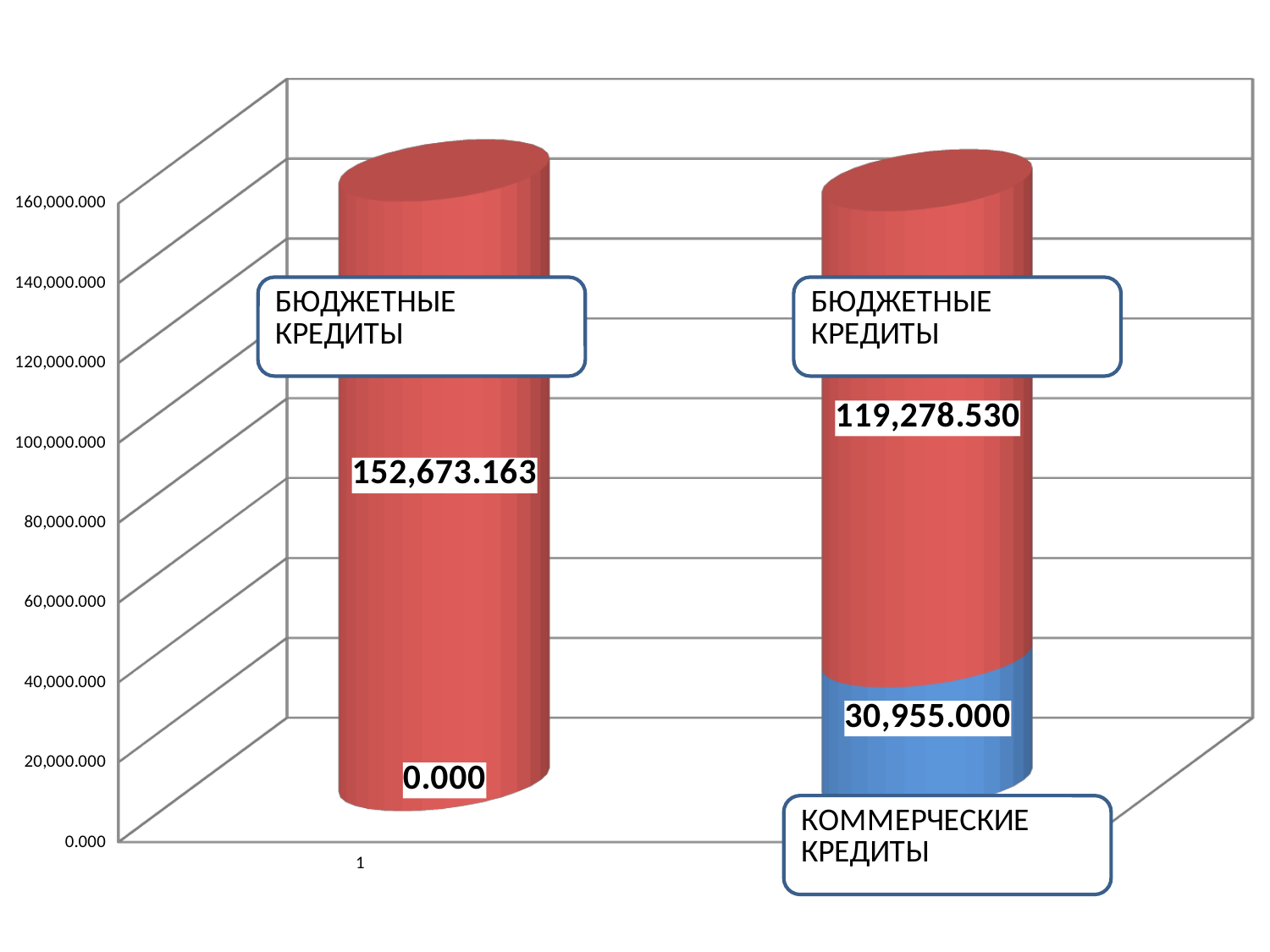
What is the difference between the budget credits values of the left bar and the right bar? 33,394.633 What is the value of the budget credits (БЮДЖЕТНЫЕ КРЕДИТЫ) segment in the left bar? 152,673.163 What is the value of the budget credits (БЮДЖЕТНЫЕ КРЕДИТЫ) segment in the right bar? 119,278.530 What is the total of the left stacked bar? 152,673.163 How many bars are shown in the chart? 2 What value is printed at the bottom of the left bar? 0.000 What is the total of the right stacked bar? 150,233.530 What kind of chart is shown on the slide? stacked bar chart What colour is the commercial credits (КОММЕРЧЕСКИЕ КРЕДИТЫ) segment? blue What is the value of the commercial credits (КОММЕРЧЕСКИЕ КРЕДИТЫ) segment in the right bar? 30,955.000 Which bar has the larger budget credits value, the left or the right? left Which bar has the larger commercial credits value, the left or the right? right